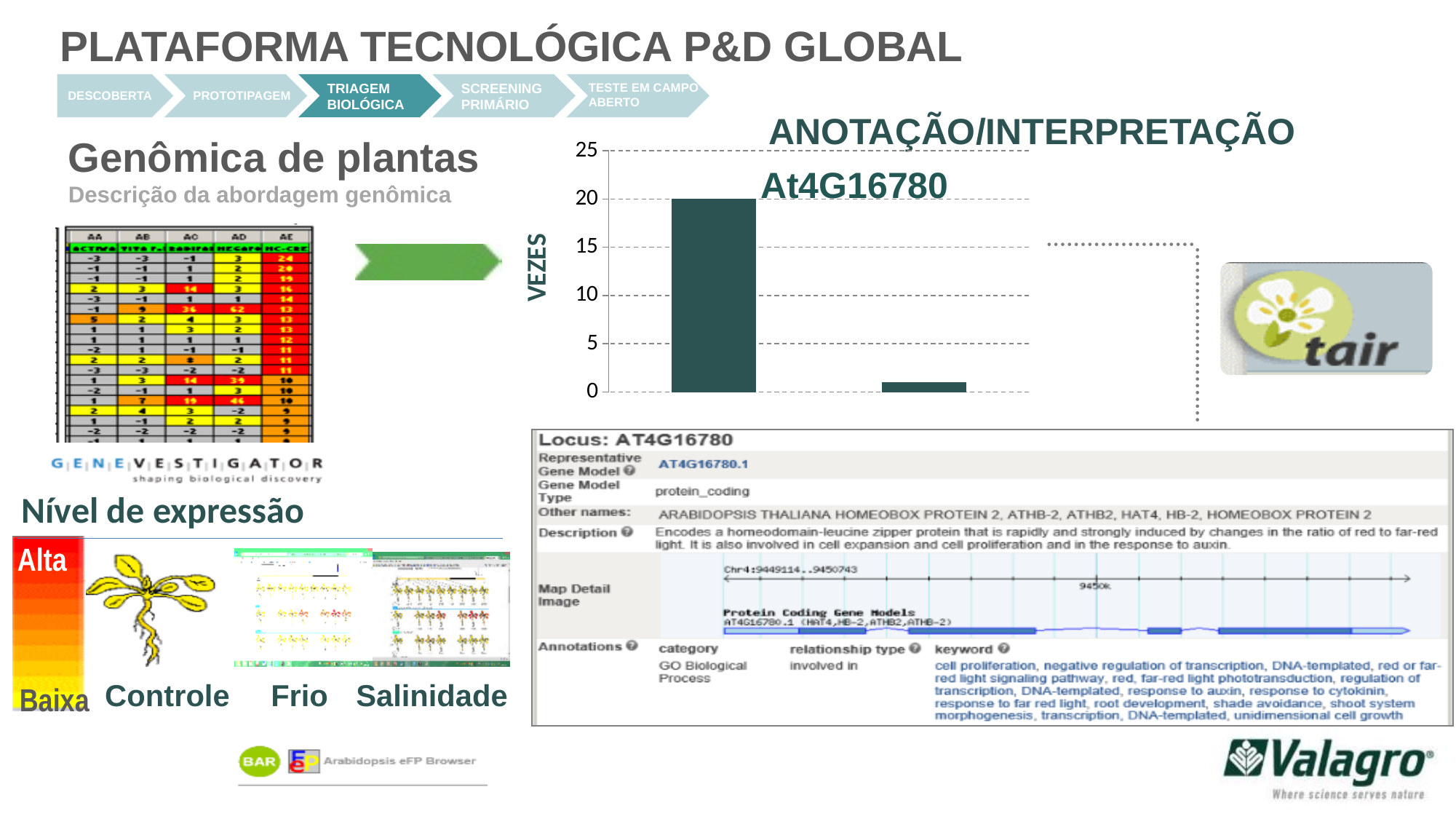
Do the bar values rise or fall from left to right in the chart? fall What is the highest tick value shown on the vertical axis of the chart? 25 What value does the left bar in the chart reach on the vertical axis? 20 Is the value of the right bar in the chart greater or less than 5? less Which bar in the chart has the lowest value? the right bar Is the value of the left bar in the chart greater or less than 15? greater How many bars are plotted in the chart? 2 What kind of chart is shown on the slide? bar chart What is the label on the vertical axis of the chart? VEZES Which bar in the chart is taller, the left one or the right one? the left one